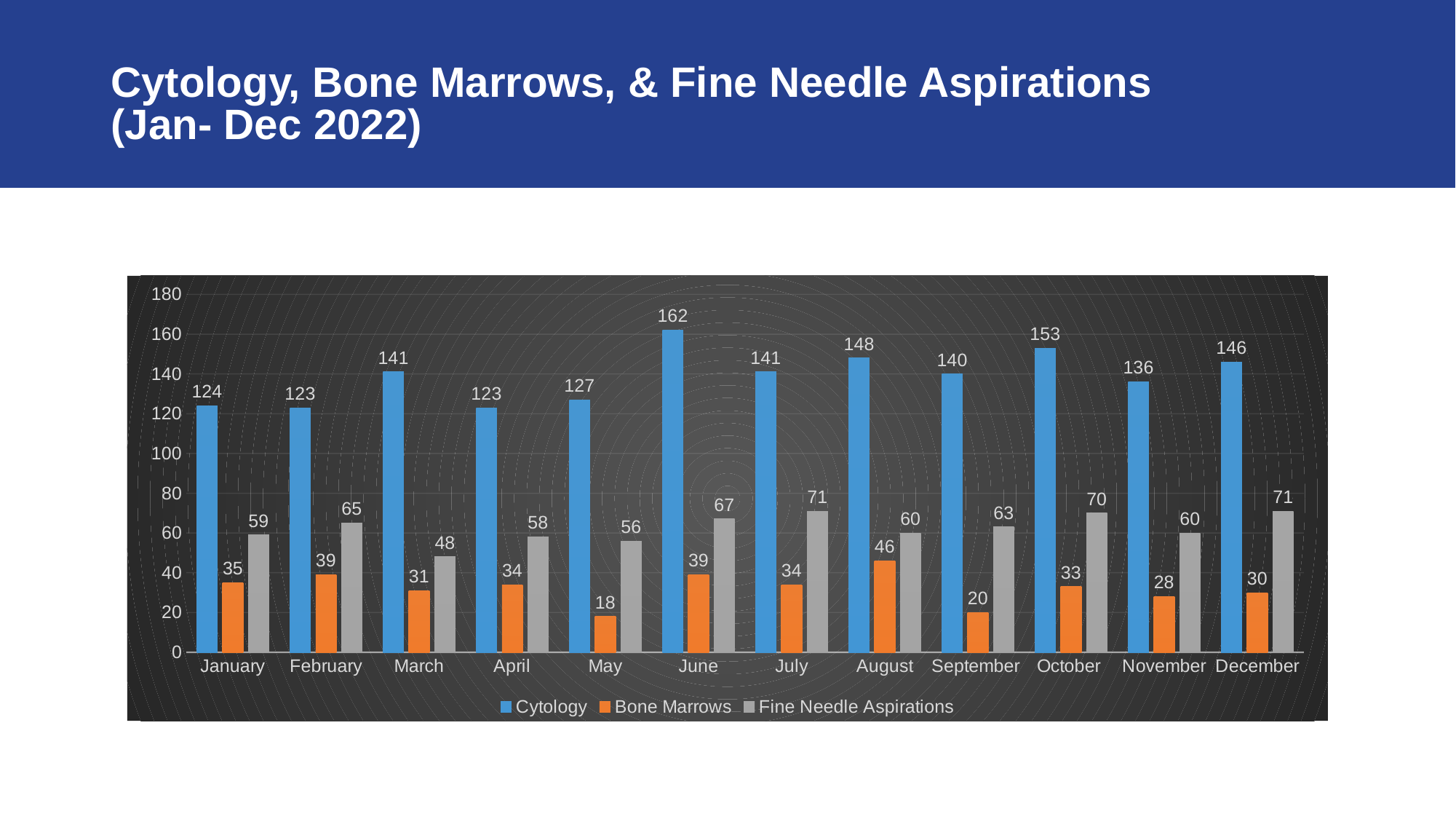
What is the Bone Marrows value for August? 46 How many series does the legend list? 3 Which month has the lowest Bone Marrows value? May Which month has the highest Cytology value? June What is the Fine Needle Aspirations value for March? 48 Which colour represents Bone Marrows in the chart? Orange How many months are shown on the x axis? 12 What is the difference between the Cytology values for October and November? 17 Is the Cytology value for September greater or less than 120? greater What is the Cytology value for June? 162 What kind of chart is shown on the slide? Bar chart Which is larger, the Fine Needle Aspirations value for February or for April? February